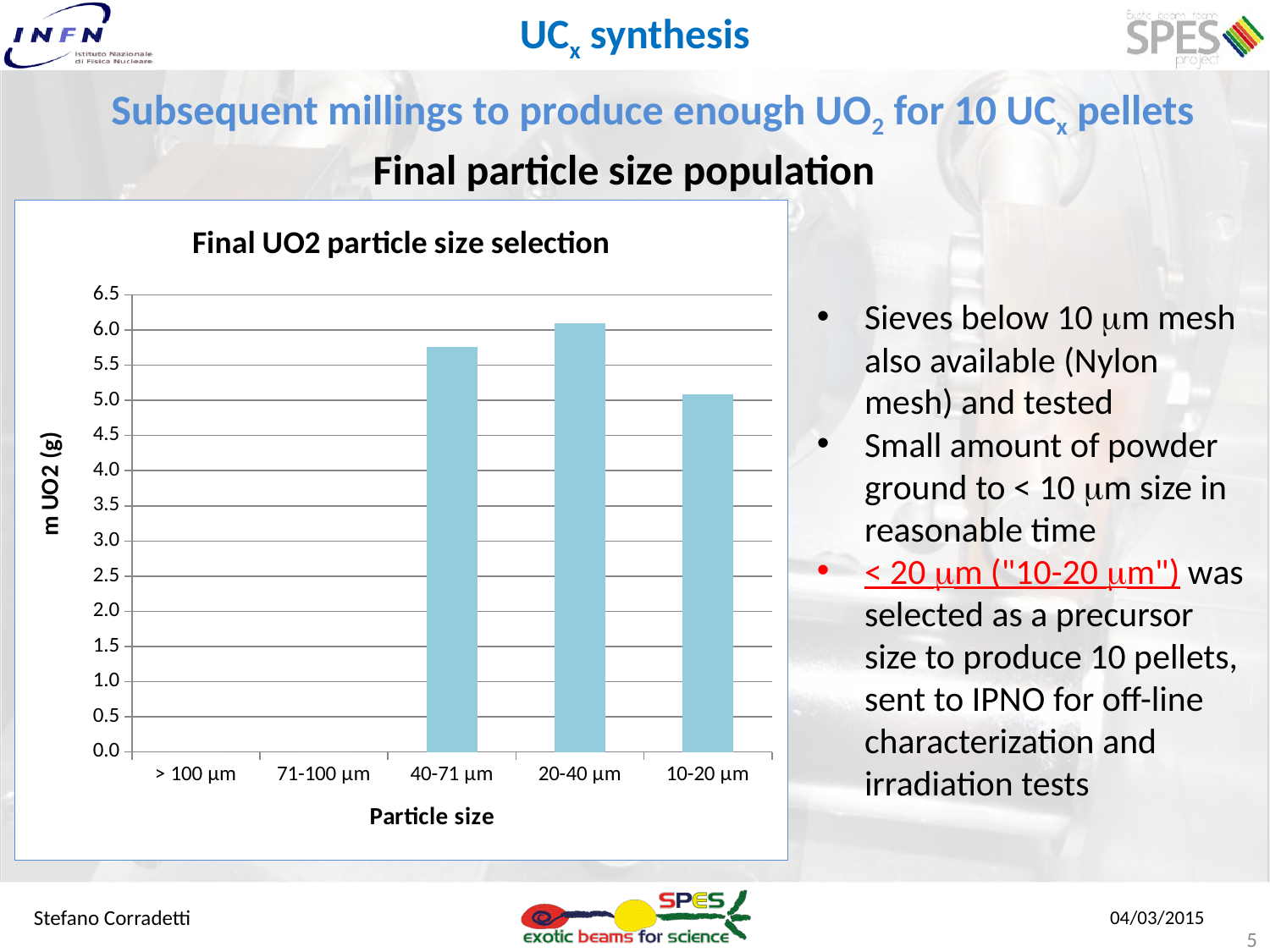
What is the title of the chart? Final UO2 particle size selection Is the value for 20-40 µm greater or less than 5.5? greater How many particle size categories are shown on the x axis of the chart? 5 Which of the three visible bars is the shortest? 10-20 µm Which has a larger m UO2 value, 40-71 µm or 10-20 µm? 40-71 µm Which particle size category has the highest m UO2 value? 20-40 µm What kind of chart is shown on the slide? bar chart Which has a larger m UO2 value, 20-40 µm or 10-20 µm? 20-40 µm Is the value for 10-20 µm greater or less than 4.5? greater Is the value for 10-20 µm greater or less than 5.5? less What is the label of the vertical axis of the chart? m UO2 (g)